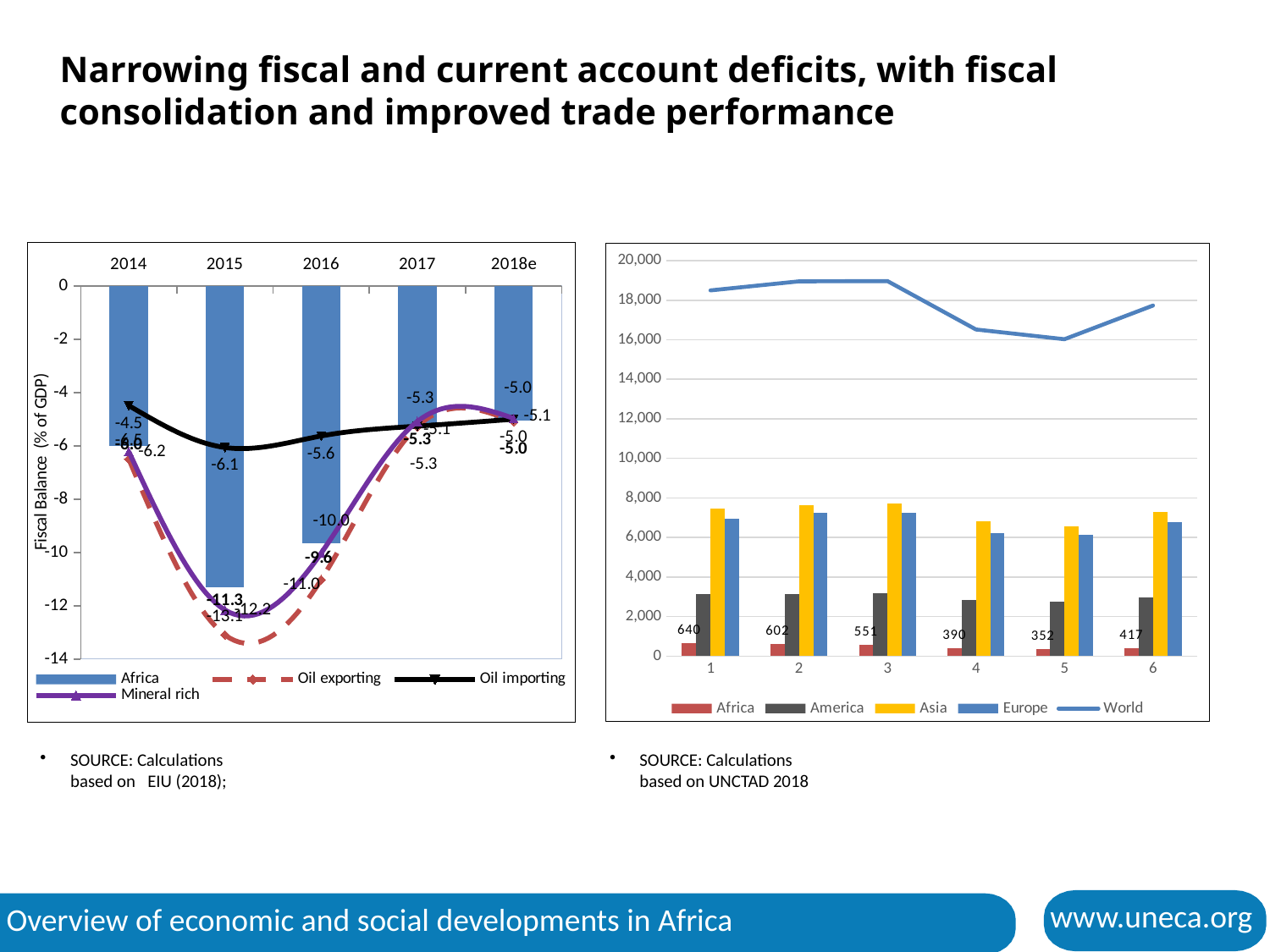
In the left-hand chart, how many series does the legend list? 4 In the right-hand chart, is the World value at category 5 greater or less than 18,000? less In the right-hand chart, how many series does the legend list? 5 In the right-hand chart, what is the value for Africa at category 1? 640 In the right-hand chart, what is the value for Africa at category 5? 352 In the right-hand chart, at which category is the Africa value lowest? 5 In the right-hand chart, how many categories are shown on the x axis? 6 What is the y-axis title of the left-hand chart? Fiscal Balance (% of GDP) In the right-hand chart, at category 1, which is larger: Asia or Europe? Asia In the right-hand chart, at which category is the Africa value highest? 1 In the left-hand chart, in which year is the Africa bar lowest? 2015 In the right-hand chart, what is the difference between the Africa values at category 1 and category 5? 288